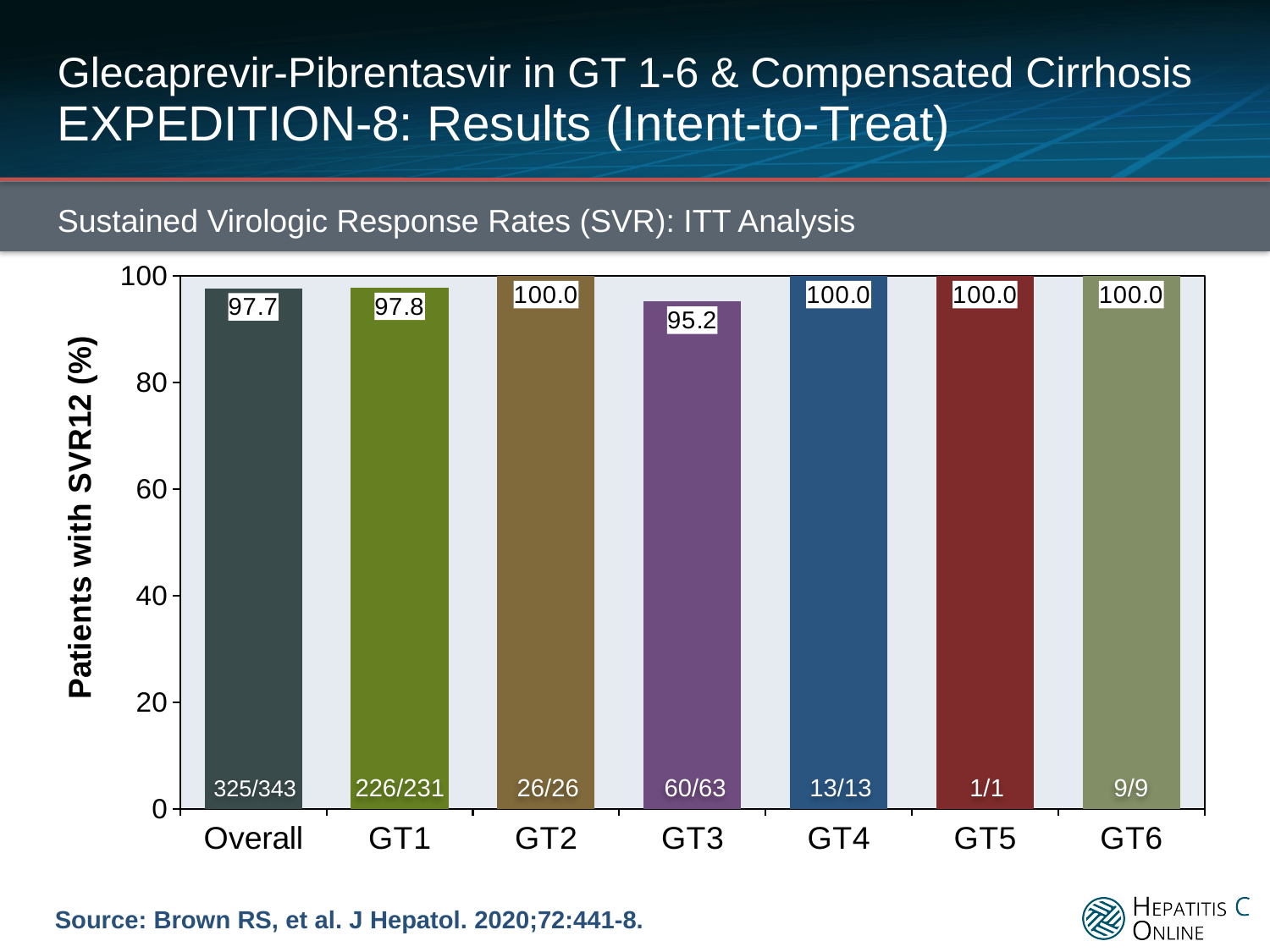
What is the SVR12 rate for GT3? 95.2 What is the SVR12 rate for the Overall group? 97.7 What is the SVR12 rate for GT1? 97.8 How many categories are shown on the x axis? 7 What is the difference in SVR12 rate between GT2 and GT3? 4.8 How many genotypes have an SVR12 rate of 100.0? 4 What fraction of patients is shown at the base of the Overall bar? 325/343 Which has a higher SVR12 rate, GT1 or GT3? GT1 What is the label of the y axis? Patients with SVR12 (%) Which genotype has the lowest SVR12 rate? GT3 What fraction of patients is shown at the base of the GT3 bar? 60/63 What kind of chart is shown on the slide? Bar chart